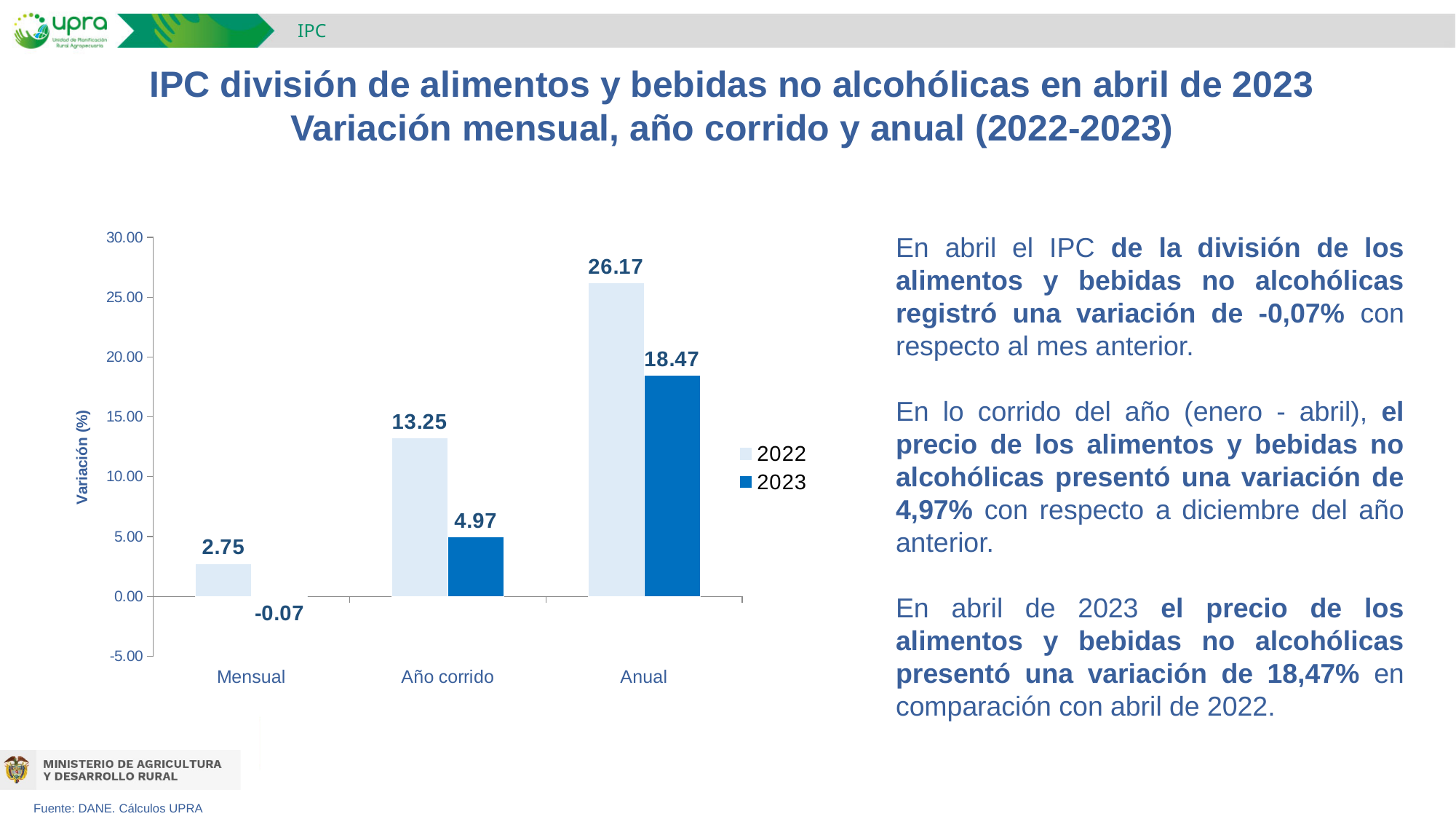
Which category has the lowest value for the 2022 series? Mensual What is the label of the vertical axis? Variación (%) What is the value for 2023 in the Mensual category? -0.07 How many categories are shown on the x axis? 3 What is the value for 2022 in the Anual category? 26.17 What is the value for 2022 in the Mensual category? 2.75 Which is larger in the Año corrido category, the 2022 value or the 2023 value? 2022 What is the value for 2023 in the Año corrido category? 4.97 How many series does the legend list? 2 Which category has the highest value for the 2023 series? Anual What is the difference between the 2022 and 2023 values in the Anual category? 7.70 What kind of chart is shown on the slide? Bar chart